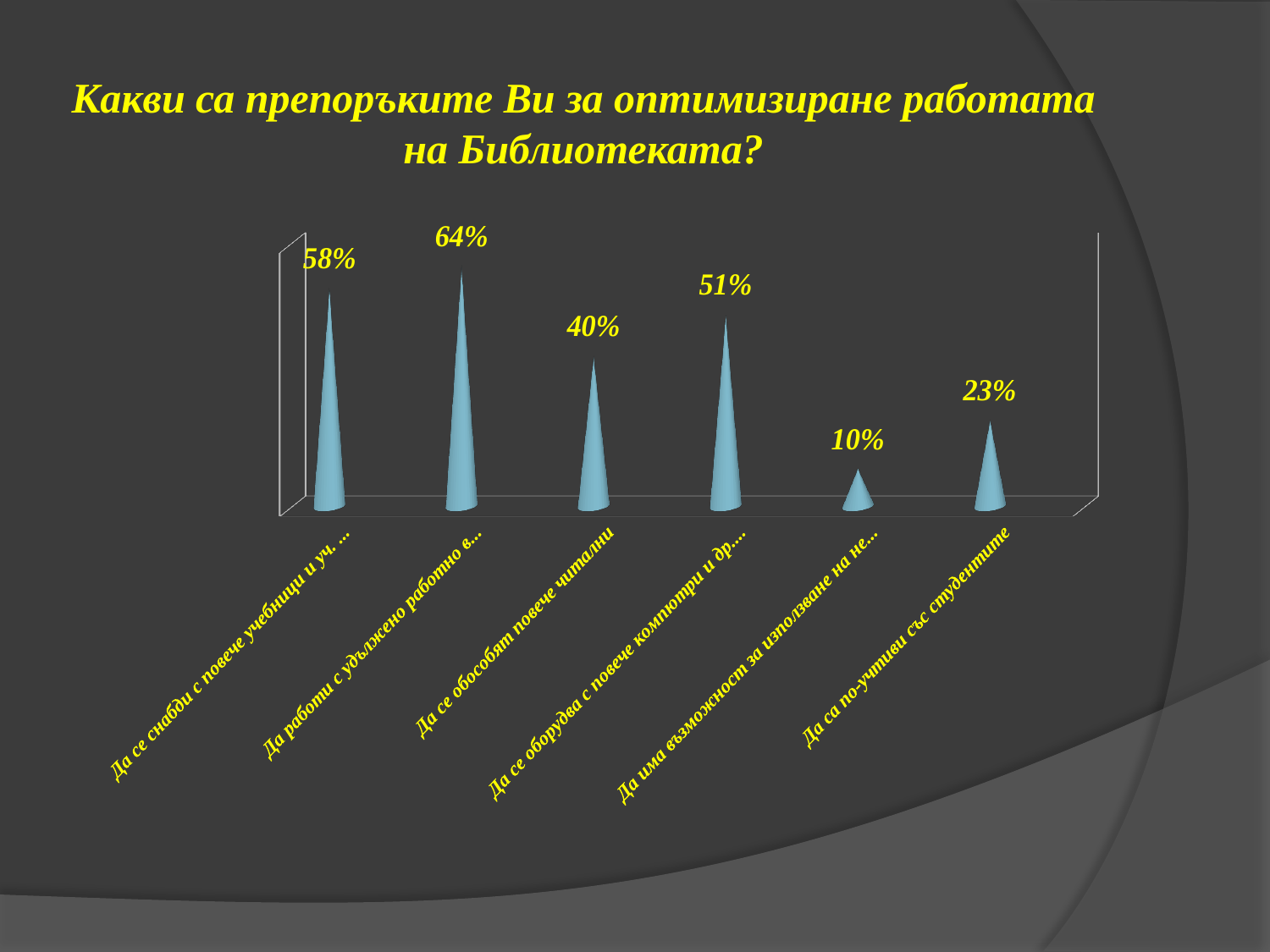
What percentage is shown for "Да се обособят повече читални"? 40% What kind of chart is shown on the slide? Bar chart How many categories are plotted in the chart? 6 Which is larger: the value for the first category (58%) or the fourth category (51%)? The first category (58%) What is the title of the slide above the chart? Какви са препоръките Ви за оптимизиране работата на Библиотеката? What value is shown for the fifth category from the left ("Да има възможност за използване на не...")? 10% Which category has the highest value? Да работи с удължено работно в... What is the difference between the highest value (64%) and the lowest value (10%)? 54% What is the difference between the values for "Да се обособят повече читални" and "Да са по-учтиви със студентите"? 17% What percentage is shown for "Да са по-учтиви със студентите"? 23% What value is shown for the second category from the left ("Да работи с удължено работно в...")? 64% Which category has the lowest value? Да има възможност за използване на не...